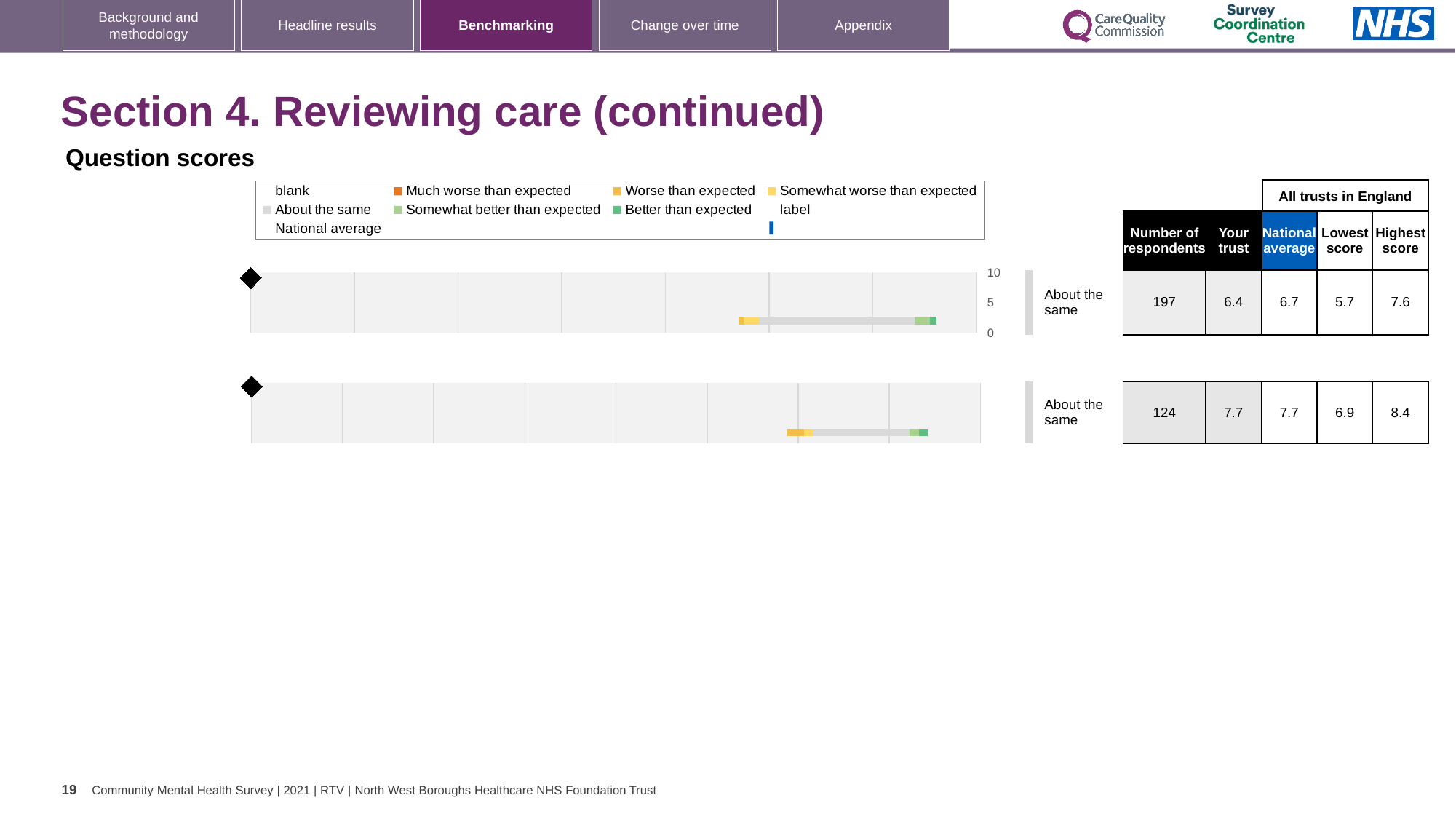
For the top chart, what is the difference between the highest score and the lowest score? 1.9 For the top chart, what is the national average score? 6.7 What kind of chart is used for the question scores on this slide? bar chart In the legend, what colour represents 'Much worse than expected'? Orange For the top chart, what is the 'Your trust' score? 6.4 For the bottom chart, what is the number of respondents? 124 For the top chart, what is the number of respondents shown in the table? 197 How many question score charts are shown on the slide? 2 For the bottom chart, what is the difference between the highest score and the lowest score? 1.5 For the bottom chart, what is the highest score among all trusts in England? 8.4 For the top chart, which is larger: the 'Your trust' score or the national average? National average What benchmark category is shown next to the bottom chart? About the same